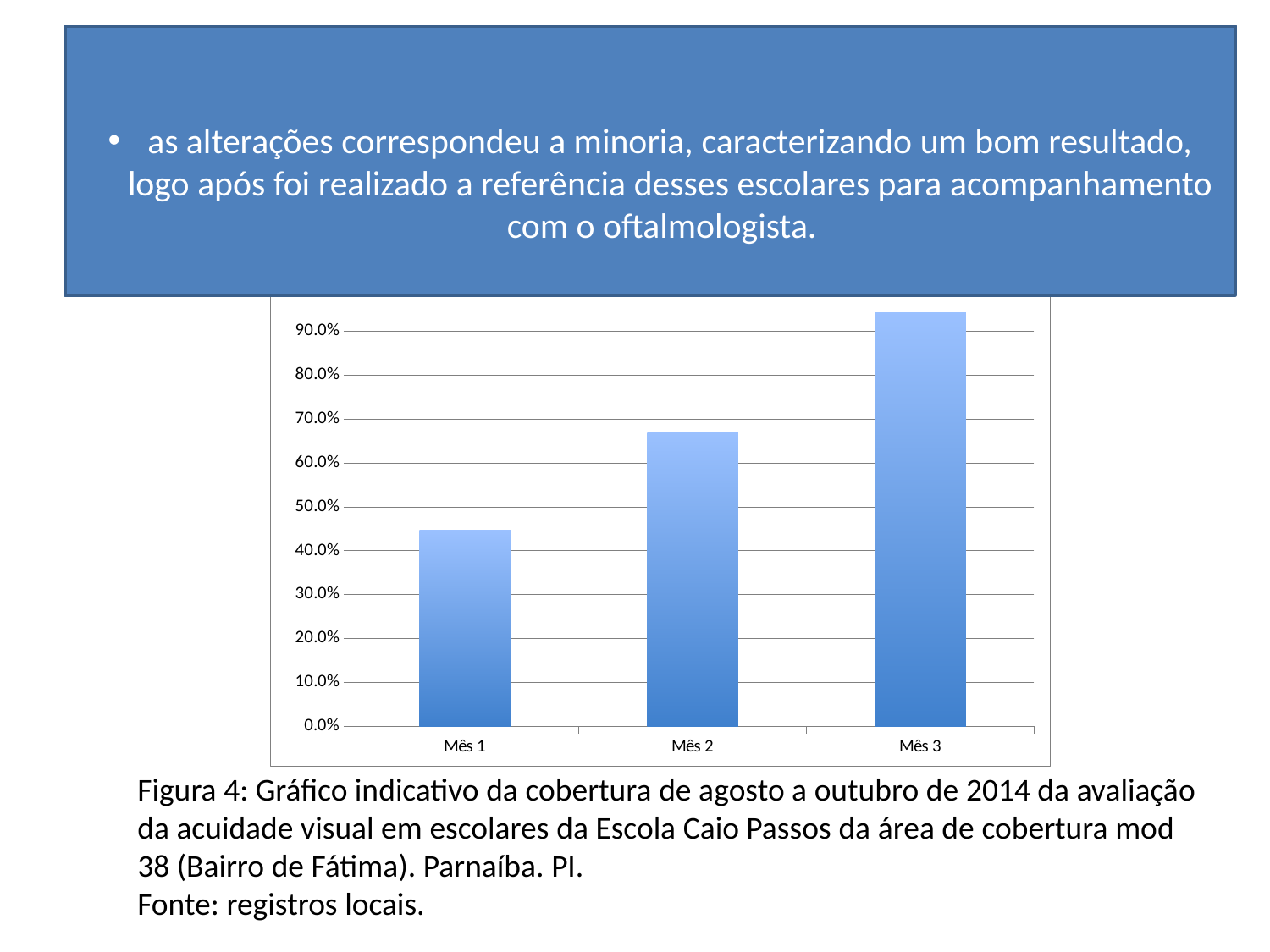
Is the value for Mês 2 greater or less than 60.0%? greater Which category has the highest value in the chart? Mês 3 Is the value for Mês 1 greater or less than 50.0%? less Which category has the lowest value in the chart? Mês 1 What kind of chart is shown on the slide? bar chart Which is larger, the value for Mês 2 or the value for Mês 3? Mês 3 Do the values rise or fall from Mês 1 to Mês 3? rise Which is larger, the value for Mês 1 or the value for Mês 2? Mês 2 How many bars (categories) does the chart show? 3 Is the value for Mês 3 greater or less than 90.0%? greater What are the category labels on the x axis of the chart? Mês 1, Mês 2, Mês 3